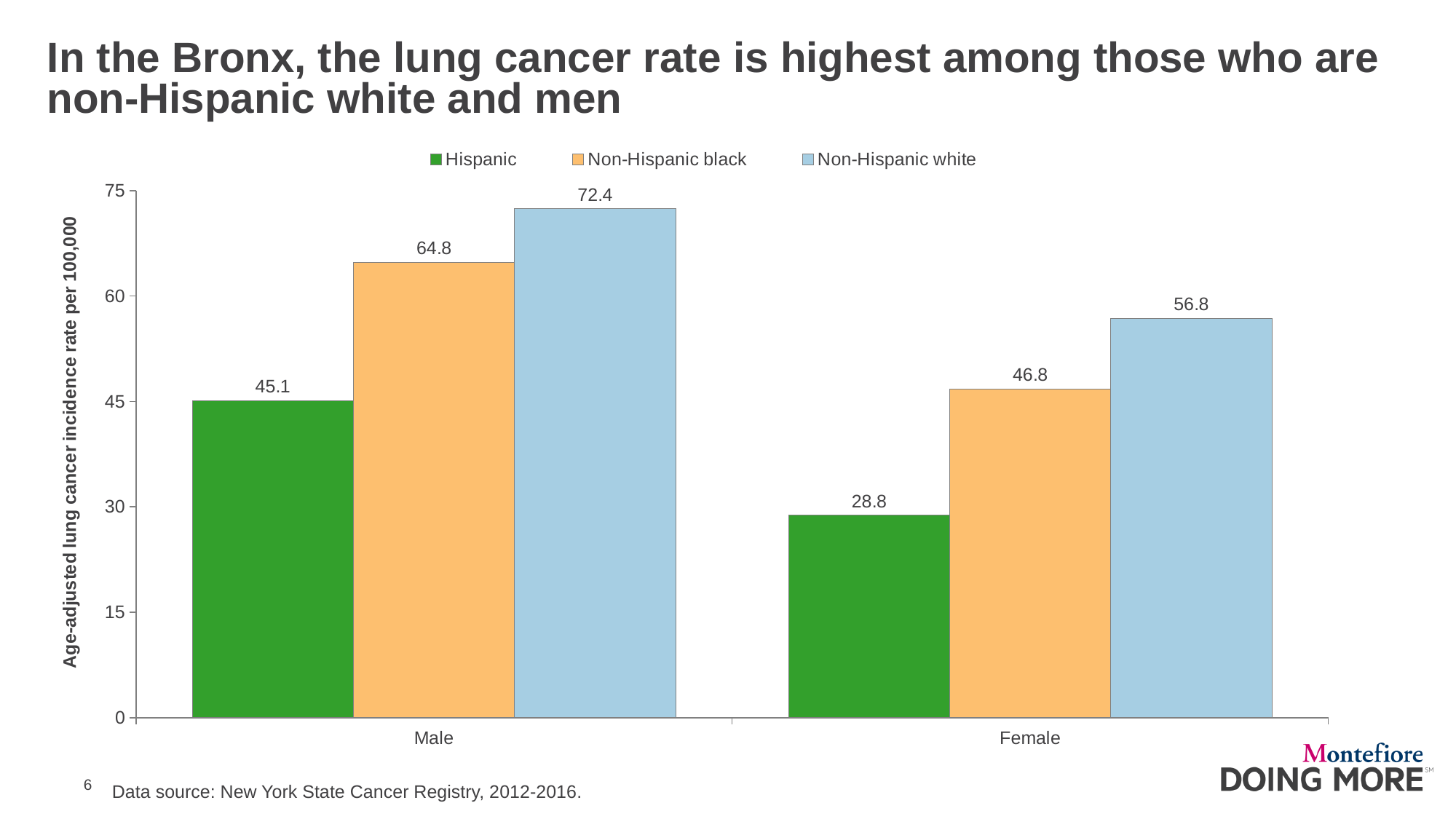
How many series does the legend list? 3 What is the difference between the lung cancer incidence rates for non-Hispanic white males and non-Hispanic white females? 15.6 What is the age-adjusted lung cancer incidence rate per 100,000 for non-Hispanic white females? 56.8 Which group has the highest lung cancer incidence rate on the chart? Non-Hispanic white males Which is larger, the lung cancer incidence rate for Hispanic males or for non-Hispanic black females? Non-Hispanic black females What is the age-adjusted lung cancer incidence rate per 100,000 for Hispanic males? 45.1 Is the lung cancer incidence rate for Hispanic females greater or less than 30? less Which group has the lowest lung cancer incidence rate on the chart? Hispanic females What is the age-adjusted lung cancer incidence rate per 100,000 for non-Hispanic black males? 64.8 What kind of chart is shown on the slide? Bar chart What colour are the bars for the Non-Hispanic black series? Orange What is the difference between the lung cancer incidence rates for non-Hispanic black females and Hispanic females? 18